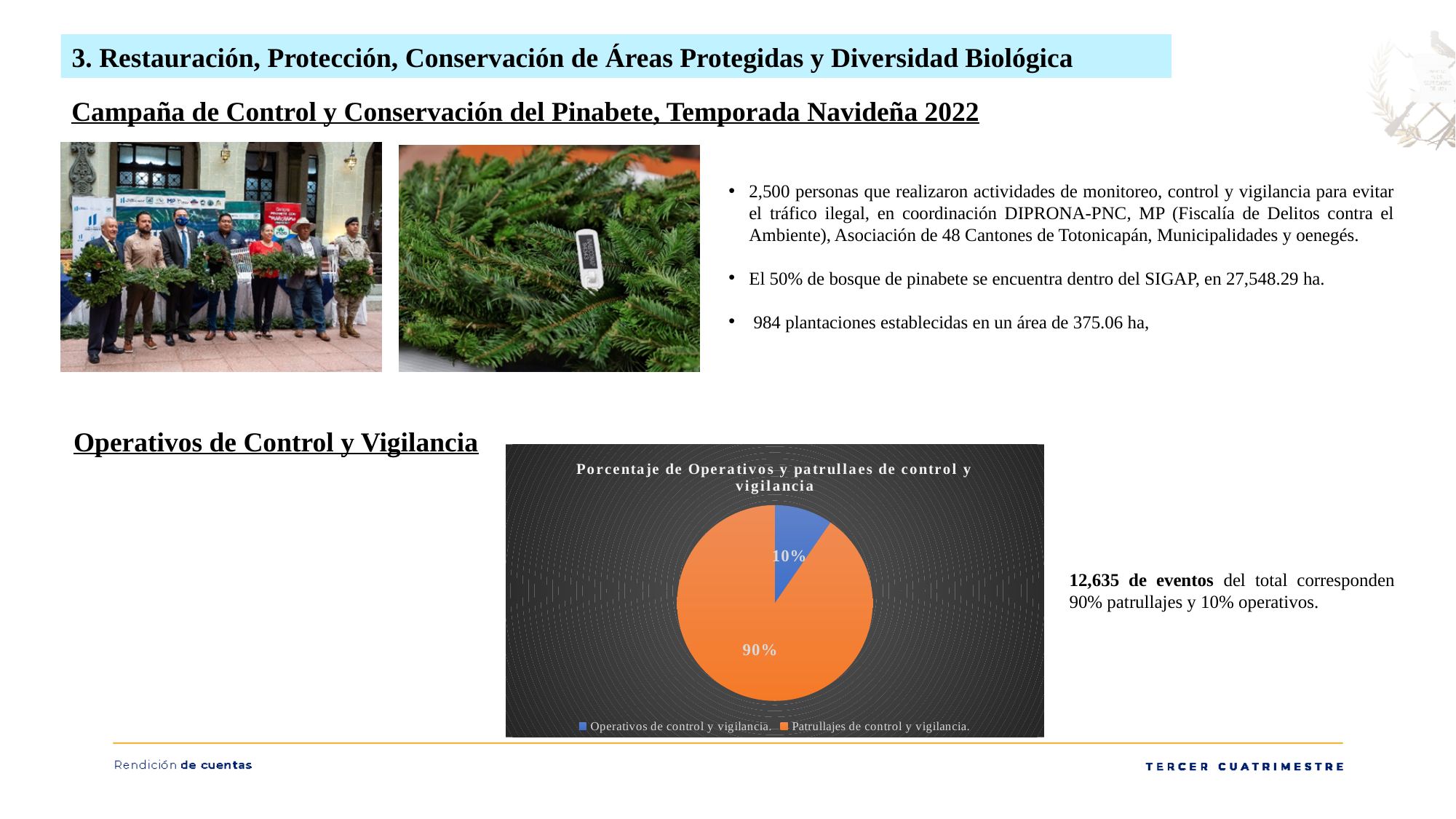
Which category has the smallest slice of the pie? Operativos de control y vigilancia. What share of the pie does 'Operativos de control y vigilancia.' represent? 10% Which is larger: the slice for 'Operativos de control y vigilancia.' or the slice for 'Patrullajes de control y vigilancia.'? Patrullajes de control y vigilancia. How many categories does the pie chart show? 2 What is the total of the two percentages shown on the pie chart? 100% What kind of chart is shown on the slide? pie chart Which category has the largest slice of the pie? Patrullajes de control y vigilancia. What share of the pie does 'Patrullajes de control y vigilancia.' represent? 90% What is the difference in percentage points between the 'Patrullajes' slice and the 'Operativos' slice? 80 What is the title of the chart? Porcentaje de Operativos y patrullaes de control y vigilancia What colour is the slice for 'Operativos de control y vigilancia.'? blue